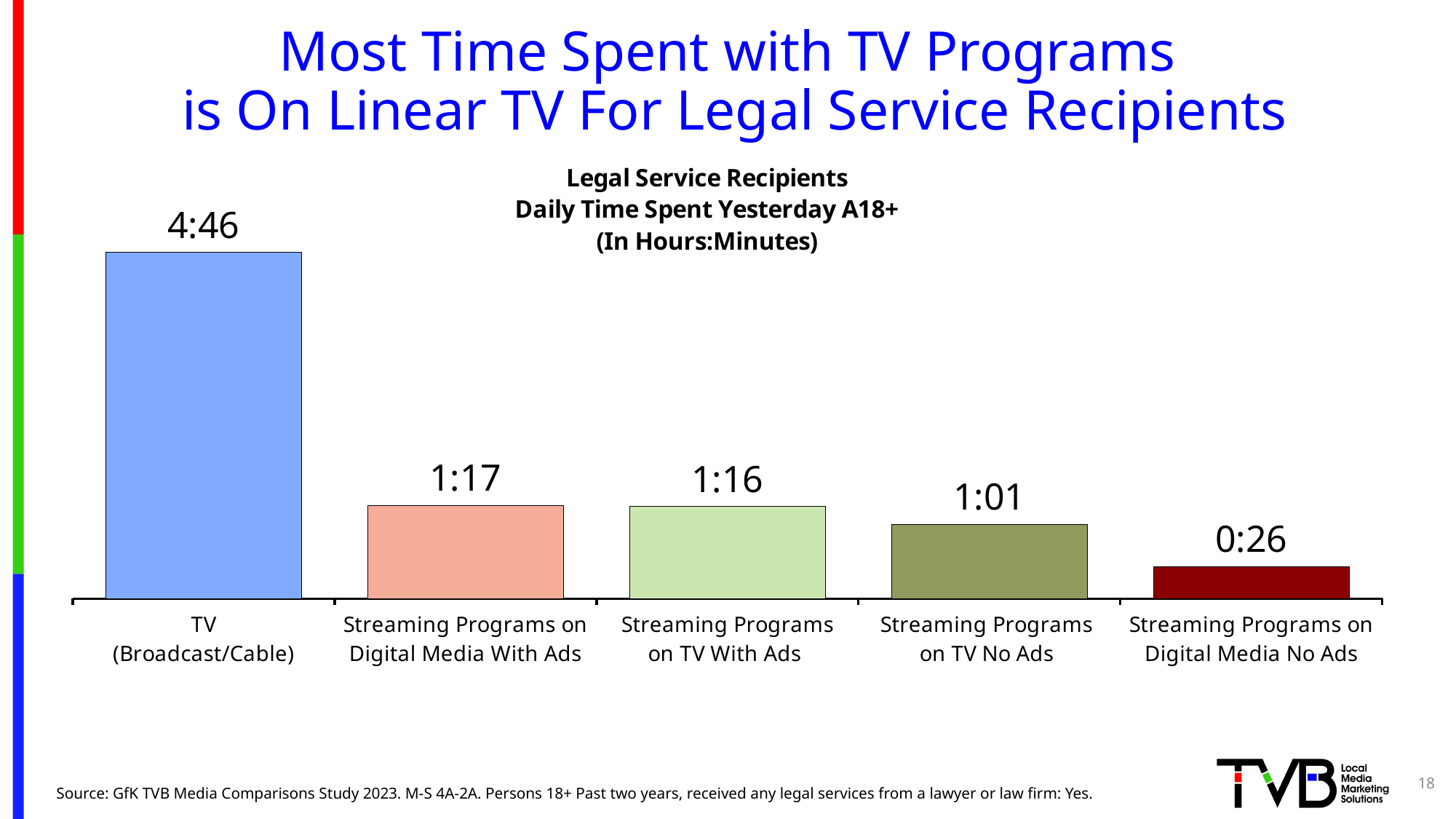
What is the daily time spent for Streaming Programs on Digital Media No Ads? 0:26 How much more daily time is spent on TV (Broadcast/Cable) than on Streaming Programs on TV With Ads? 3:30 What is the daily time spent for Streaming Programs on TV No Ads? 1:01 How many categories are shown in the chart? 5 Which category has the lowest daily time spent? Streaming Programs on Digital Media No Ads In what units are the values in the chart expressed? Hours:Minutes Which has a larger daily time spent: Streaming Programs on TV No Ads or Streaming Programs on Digital Media No Ads? Streaming Programs on TV No Ads What is the daily time spent for Streaming Programs on Digital Media With Ads? 1:17 What is the difference in daily time spent between Streaming Programs on TV No Ads and Streaming Programs on Digital Media No Ads? 0:35 Which category has the highest daily time spent? TV (Broadcast/Cable) What type of chart is shown on the slide? Bar chart What is the daily time spent for TV (Broadcast/Cable)? 4:46